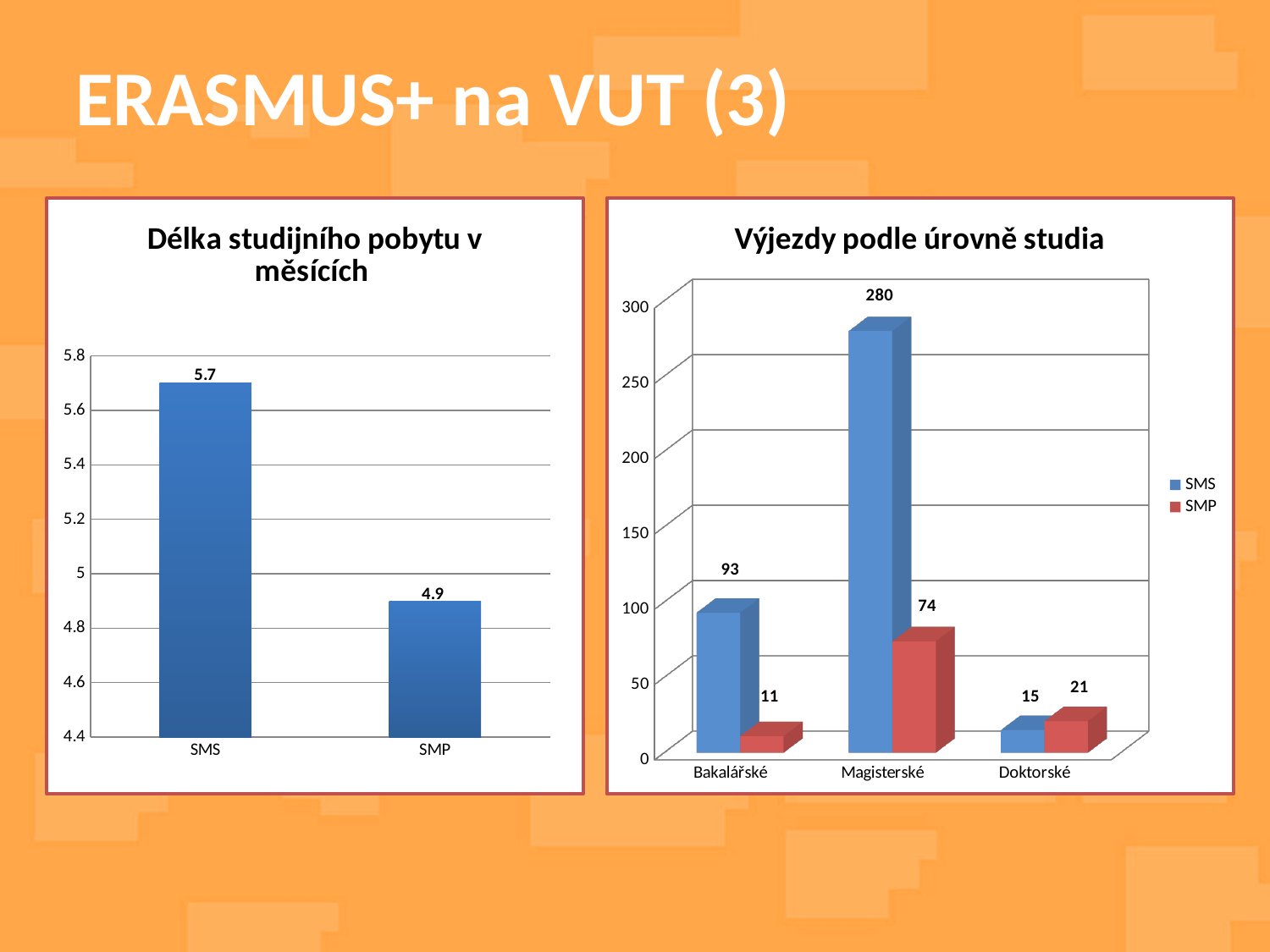
In the chart 'Výjezdy podle úrovně studia', what is the SMS value for Magisterské? 280 In the chart 'Výjezdy podle úrovně studia', which category has the lowest SMP value? Bakalářské In the chart 'Délka studijního pobytu v měsících', what is the value for SMS? 5.7 In the chart 'Délka studijního pobytu v měsících', what is the difference between the SMS and SMP values? 0.8 What kind of chart is 'Výjezdy podle úrovně studia'? Bar chart In the chart 'Výjezdy podle úrovně studia', what is the difference between the SMS and SMP values for Magisterské? 206 In the chart 'Délka studijního pobytu v měsících', what is the value for SMP? 4.9 In the chart 'Výjezdy podle úrovně studia', how many series does the legend list? 2 In the chart 'Výjezdy podle úrovně studia', what is the SMP value for Bakalářské? 11 In the chart 'Délka studijního pobytu v měsících', how many categories are shown? 2 In the chart 'Výjezdy podle úrovně studia', which category has the highest SMS value? Magisterské In the chart 'Výjezdy podle úrovně studia', for Doktorské, which is larger: SMS or SMP? SMP